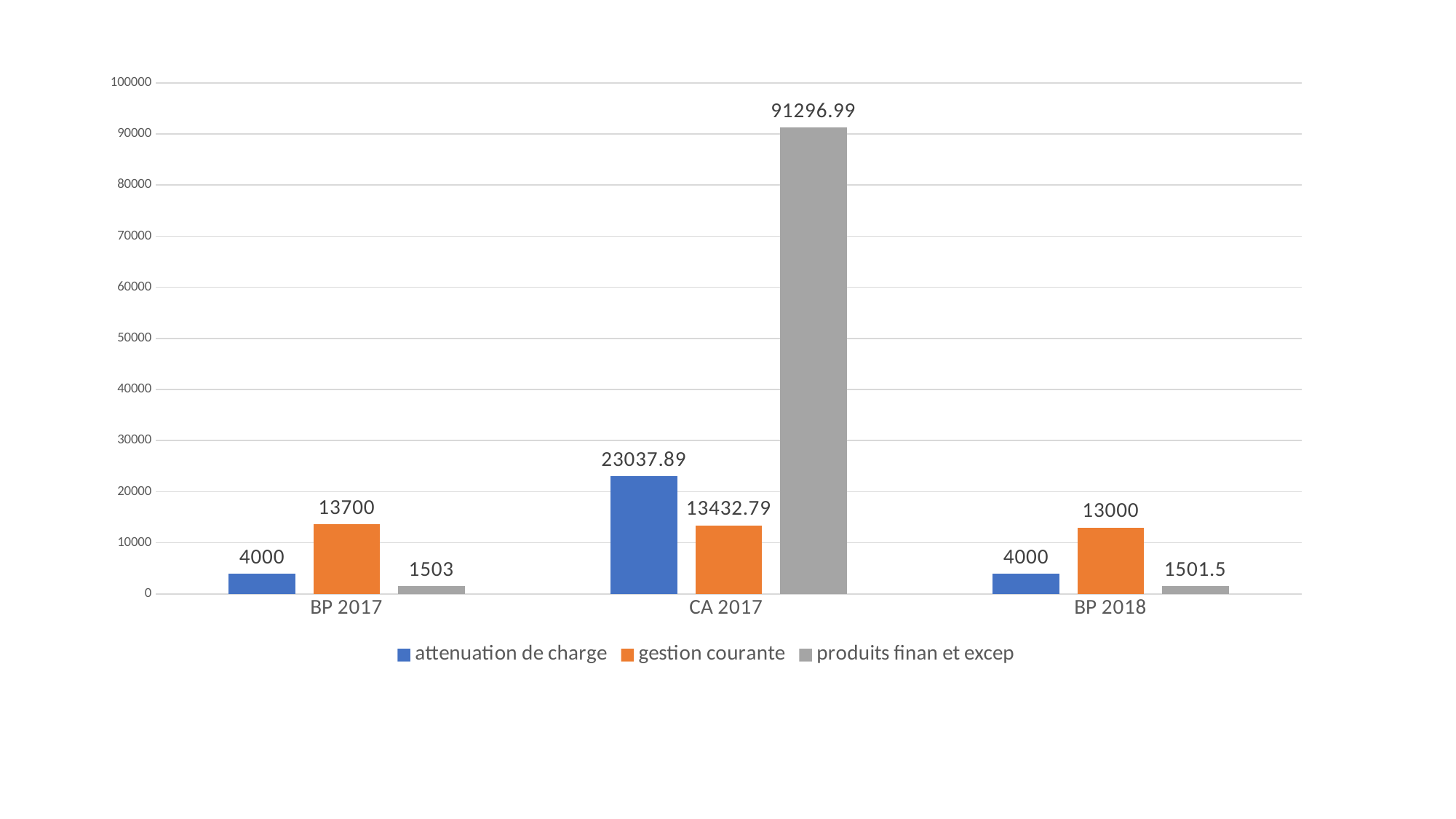
What colour represents gestion courante in the legend? orange What is the value of produits finan et excep for BP 2018? 1501.5 What kind of chart is shown on the slide? bar chart How many categories are shown on the x axis? 3 What is the difference between gestion courante for BP 2017 and BP 2018? 700 What is the value of attenuation de charge for CA 2017? 23037.89 How many series does the legend list? 3 Which is larger: attenuation de charge for CA 2017 or gestion courante for CA 2017? attenuation de charge for CA 2017 Which category has the highest value for produits finan et excep? CA 2017 What is the value of produits finan et excep for CA 2017? 91296.99 Which category has the lowest value for gestion courante? BP 2018 What is the value of gestion courante for BP 2017? 13700